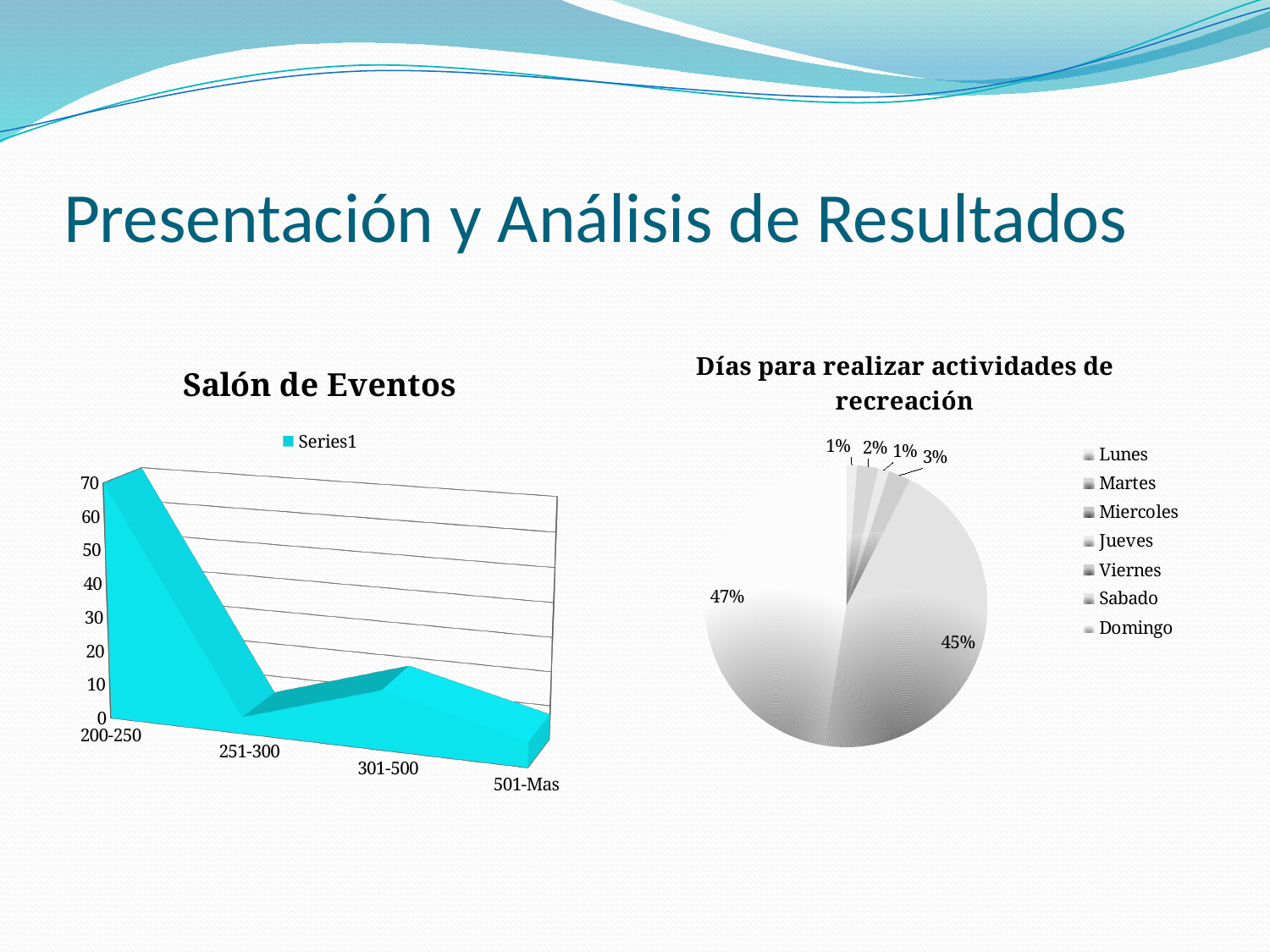
In the "Salón de Eventos" chart, which category has the highest value? 200-250 In the "Días para realizar actividades de recreación" chart, what is the largest percentage label shown? 47% In the "Salón de Eventos" chart, which has the larger value, 251-300 or 301-500? 301-500 How many entries does the legend of the "Días para realizar actividades de recreación" chart list? 7 In the "Salón de Eventos" chart, is the value for 251-300 greater or less than 20? less What type of chart is "Días para realizar actividades de recreación"? pie chart How many categories are shown on the x axis of the "Salón de Eventos" chart? 4 What type of chart is the "Salón de Eventos" chart? area chart How many series does the legend of the "Salón de Eventos" chart list? 1 In the "Salón de Eventos" chart, is the value for 301-500 greater or less than 30? less In the "Salón de Eventos" chart, is the value for 200-250 greater or less than 60? greater In the "Salón de Eventos" chart, which category has the lowest value? 251-300